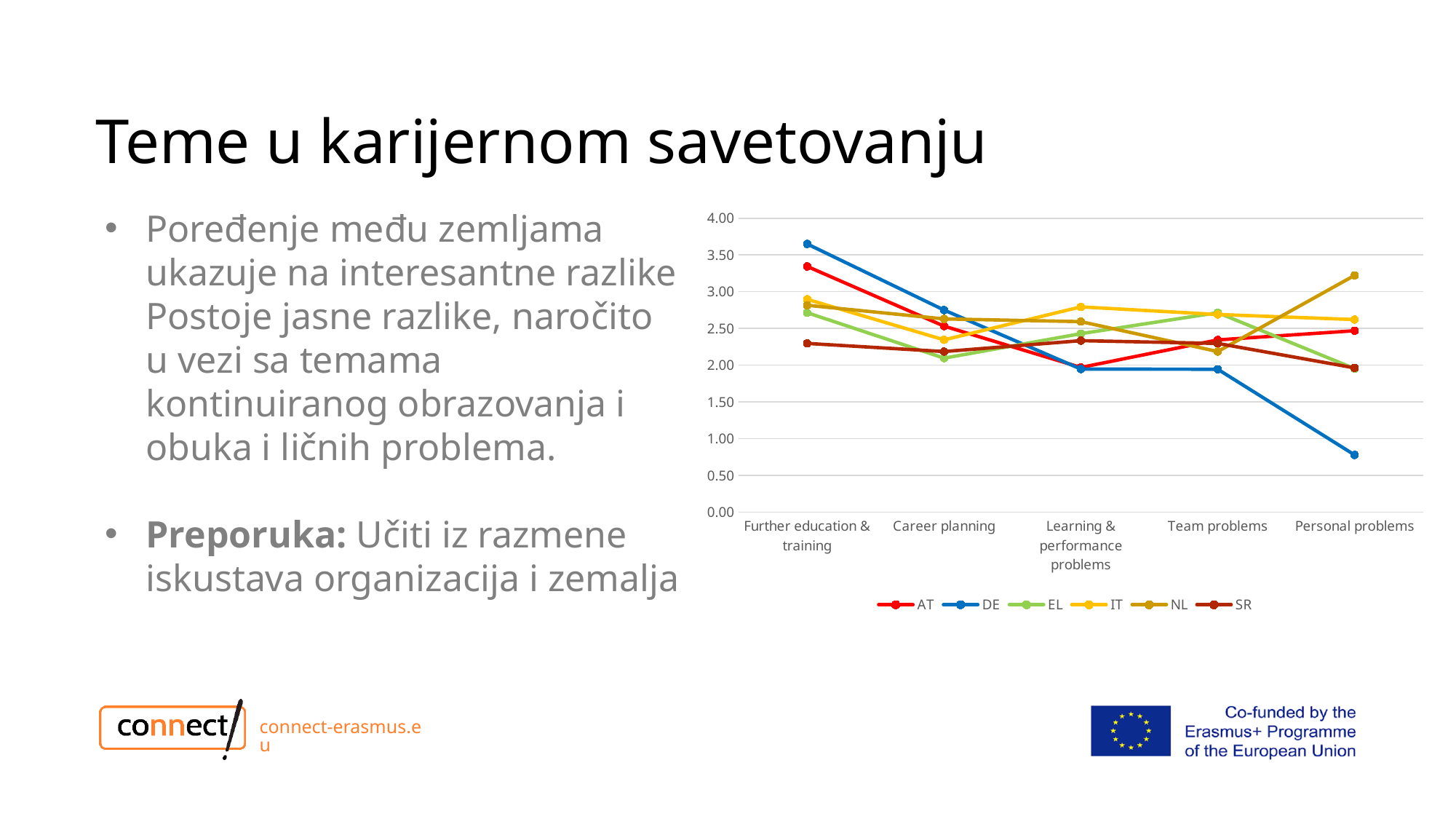
Is the value for DE at Further education & training greater or less than 3.50? greater Which series has the highest value for Personal problems? NL How many series does the chart's legend list? 6 Which series has the highest value for Further education & training? DE What kind of chart is shown on the slide? line chart Does the DE line rise or fall from Further education & training to Personal problems? fall Which is larger at Further education & training, the value for AT or the value for SR? AT Is the value for NL at Personal problems greater or less than 3.00? greater What colour is the DE line in the chart? blue How many categories are shown along the x axis of the chart? 5 Which series has the lowest value for Personal problems? DE Is the value for DE at Personal problems greater or less than 1.00? less